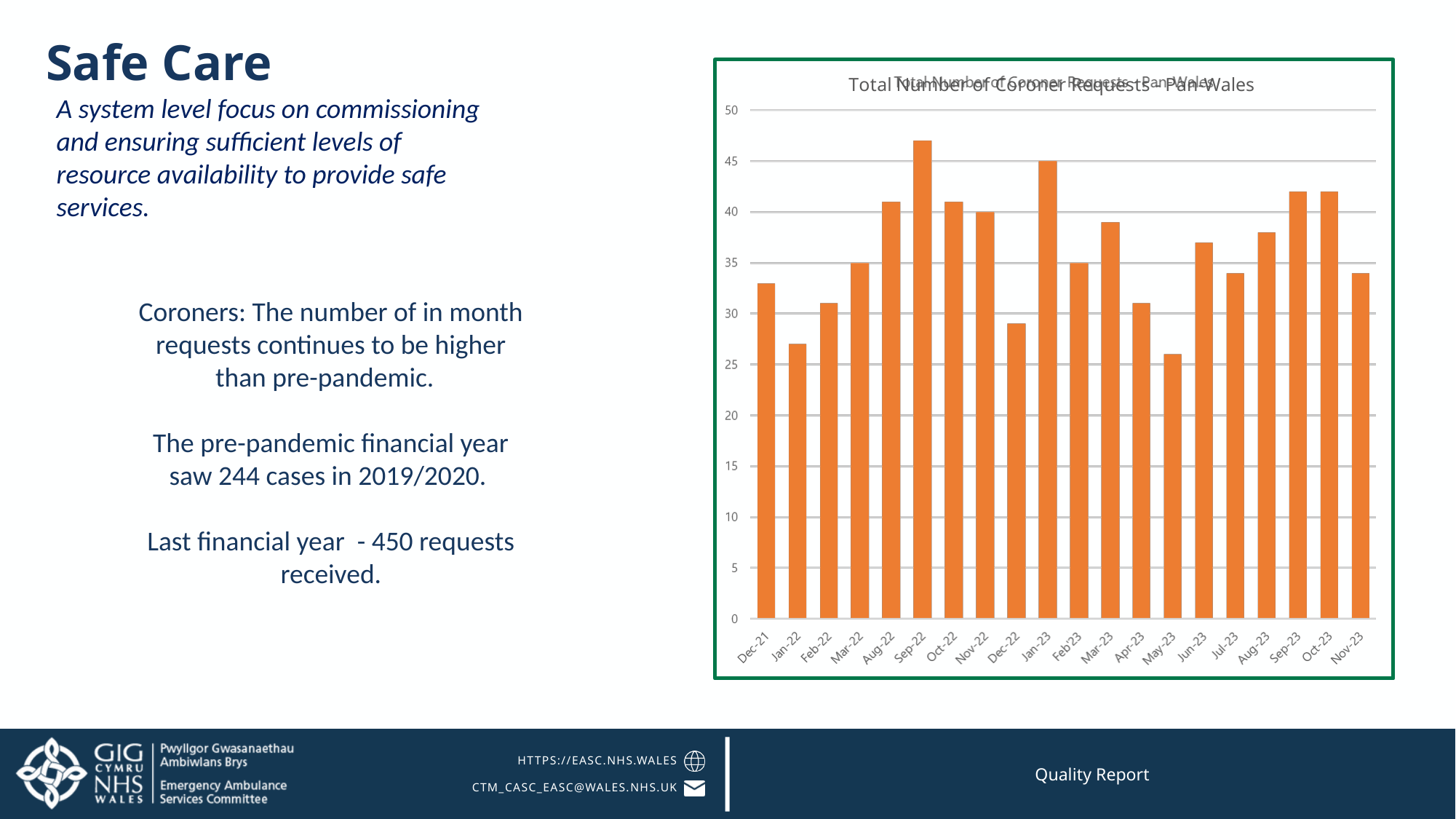
Do the values rise or fall from Jan-22 to Sep-22? Rise Which is larger, the value for Sep-22 or the value for Dec-22? Sep-22 Is the value for Dec-21 greater or less than 30? greater How many months are shown on the x axis of the chart? 20 Is the value for Sep-22 greater or less than 45? greater Is the value for Dec-22 greater or less than 30? less What is the title of the chart? Total Number of Coroner Requests - Pan-Wales Which is larger, the value for Jan-23 or the value for May-23? Jan-23 What type of chart is shown on the slide? Bar chart Which month has the highest number of coroner requests? Sep-22